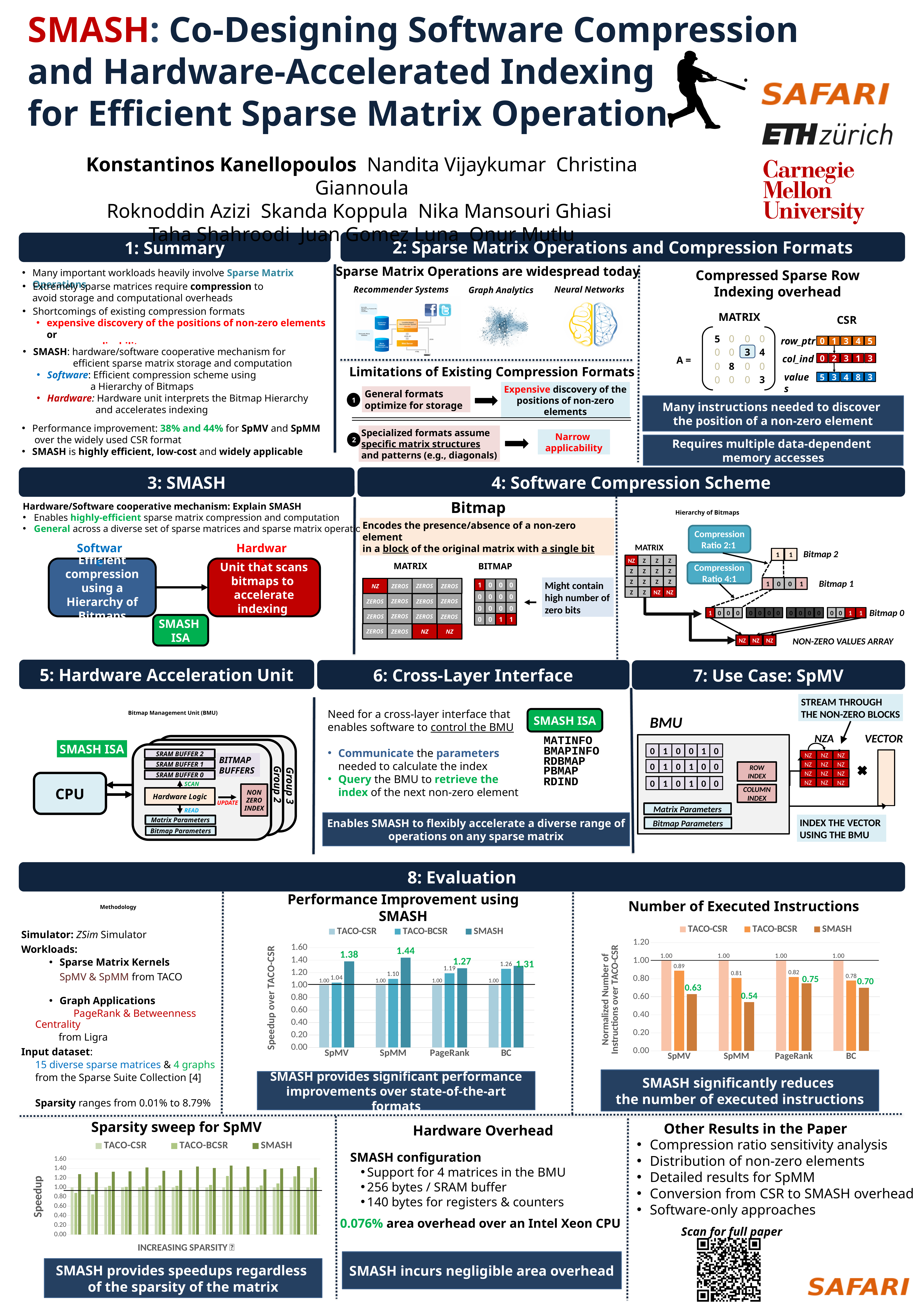
In the 'Performance Improvement using SMASH' chart, which workload has the highest SMASH speedup? SpMM In the 'Number of Executed Instructions' chart, what is the SMASH value for SpMM? 0.54 In the 'Number of Executed Instructions' chart, is the SMASH value for PageRank larger or smaller than the SMASH value for BC? larger In the 'Performance Improvement using SMASH' chart, how many workload categories are shown on the x axis? 4 In the 'Performance Improvement using SMASH' chart, what is the difference between the SMASH and TACO-BCSR values for SpMV? 0.34 In the 'Number of Executed Instructions' chart, which workload has the lowest SMASH value? SpMM In the 'Number of Executed Instructions' chart, what is the TACO-BCSR value for BC? 0.78 In the 'Performance Improvement using SMASH' chart, what is the SMASH speedup for SpMM? 1.44 In the 'Performance Improvement using SMASH' chart, how many series does the legend list? 3 In the 'Number of Executed Instructions' chart, what is the difference between the TACO-CSR and SMASH values for SpMV? 0.37 In the 'Performance Improvement using SMASH' chart, what is the TACO-BCSR value for PageRank? 1.19 What kind of chart is the 'Sparsity sweep for SpMV' chart? bar chart